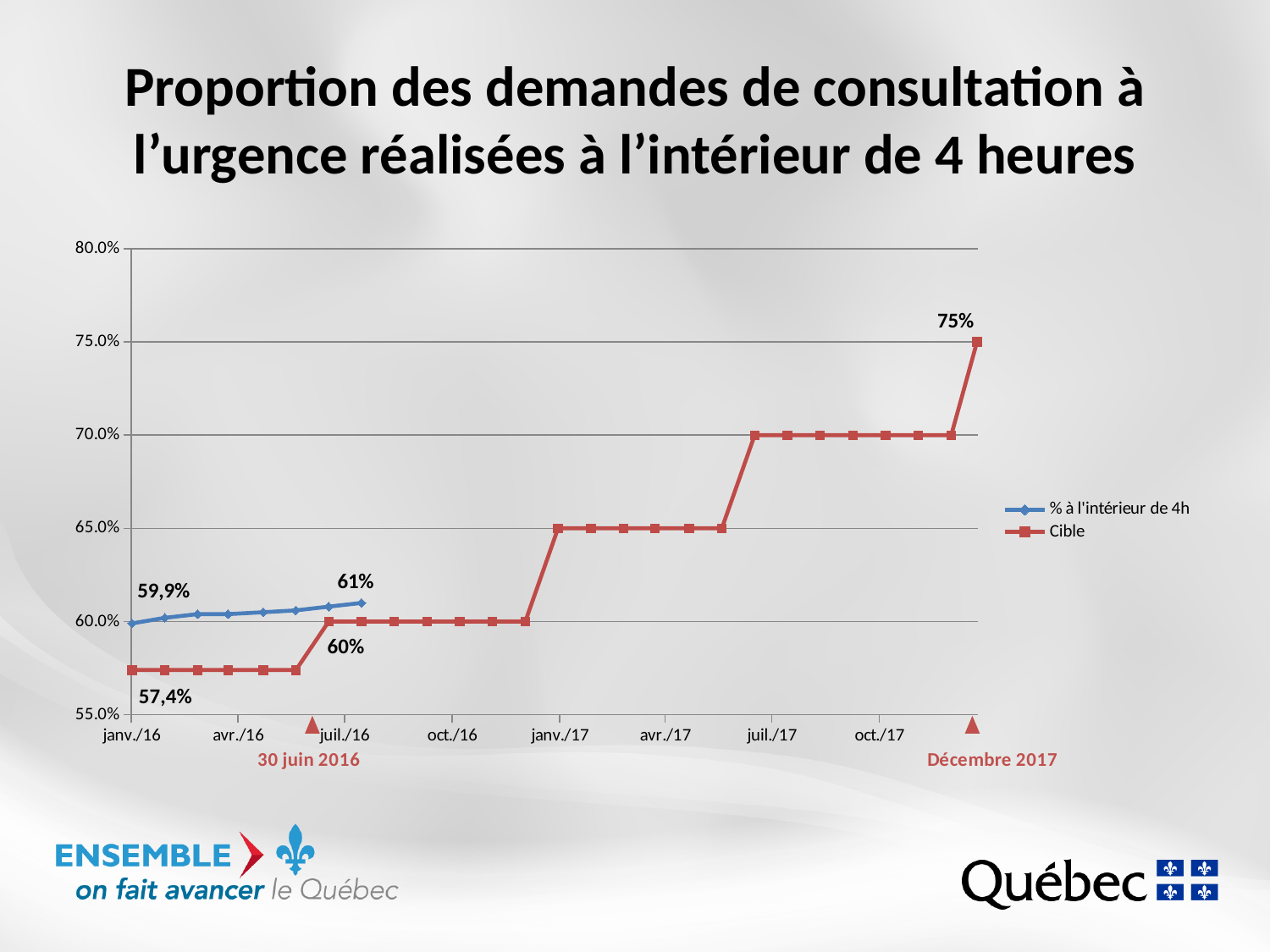
Is the 'Cible' value in avr./17 greater or less than 70.0%? less What kind of chart is shown on the slide? line chart What is the first labelled value of the '% à l'intérieur de 4h' series in janv./16? 59,9% Which is larger in janv./16: the '% à l'intérieur de 4h' value or the 'Cible' value? % à l'intérieur de 4h Does the 'Cible' series rise or fall from janv./16 to Décembre 2017? rise What is the 'Cible' value labelled for Décembre 2017? 75% How many series does the legend list? 2 What is the highest value shown for the 'Cible' series? 75% What is the starting value of the 'Cible' series in janv./16? 57,4% What are the two series named in the legend? % à l'intérieur de 4h and Cible What is the last labelled value of the '% à l'intérieur de 4h' series, near juil./16? 61% What is the 'Cible' value labelled at 30 juin 2016? 60%